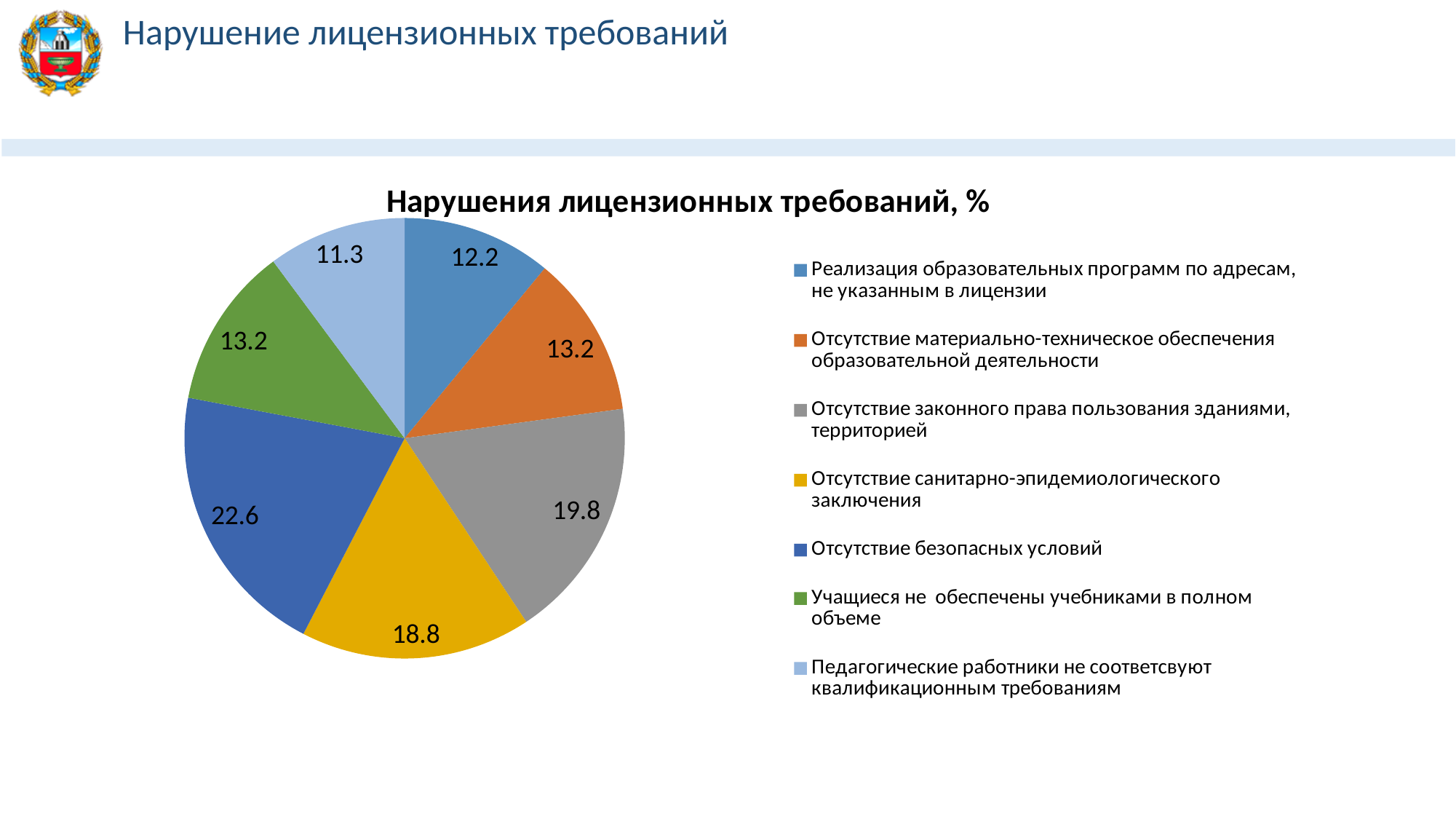
What type of chart is shown on the slide? pie chart What colour is the slice for "Учащиеся не обеспечены учебниками в полном объеме"? green Which category has the smallest slice of the pie? Педагогические работники не соответсвуют квалификационным требованиям What is the value for "Реализация образовательных программ по адресам, не указанным в лицензии"? 12.2 Which is larger: the value for "Отсутствие законного права пользования зданиями, территорией" or the value for "Отсутствие санитарно-эпидемиологического заключения"? Отсутствие законного права пользования зданиями, территорией What is the value for "Отсутствие санитарно-эпидемиологического заключения"? 18.8 Which category has the largest slice of the pie? Отсутствие безопасных условий What is the difference between the values for "Отсутствие безопасных условий" and "Отсутствие законного права пользования зданиями, территорией"? 2.8 What is the title of the chart? Нарушения лицензионных требований, % What is the value for "Отсутствие безопасных условий"? 22.6 How many slices does the pie chart have? 7 What is the value for "Педагогические работники не соответсвуют квалификационным требованиям"? 11.3